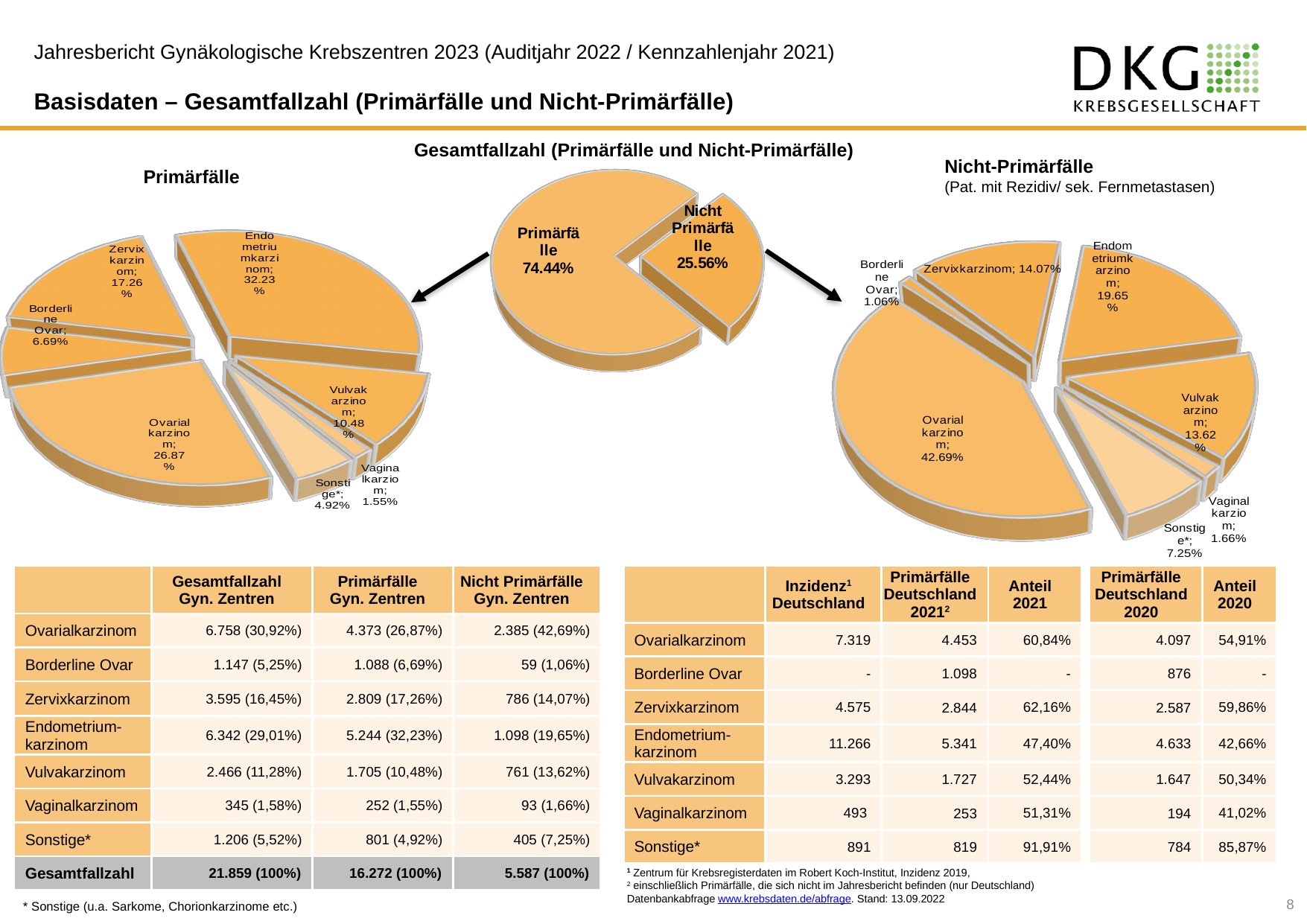
In the Gesamtfallzahl (Primärfälle und Nicht-Primärfälle) pie chart in the centre, what share is shown for Nicht Primärfälle? 25.56% In the Gesamtfallzahl (Primärfälle und Nicht-Primärfälle) pie chart in the centre, what share is shown for Primärfälle? 74.44% In the Nicht-Primärfälle pie chart, which category has the smallest slice? Borderline Ovar In the Nicht-Primärfälle pie chart, what is the difference between the shares for Endometriumkarzinom and Zervixkarzinom? 5.58% In the Primärfälle pie chart, which category has the smallest slice? Vaginalkarzinom In the Primärfälle pie chart, how many slices are there? 7 In the Primärfälle pie chart, what share is shown for Endometriumkarzinom? 32.23% In the Nicht-Primärfälle pie chart, what share is shown for Ovarialkarzinom? 42.69% What kind of chart is the Gesamtfallzahl (Primärfälle und Nicht-Primärfälle) chart in the centre of the slide? Pie chart In the Nicht-Primärfälle pie chart, which is larger: Zervixkarzinom or Vulvakarzinom? Zervixkarzinom In the Primärfälle pie chart, what share is shown for Ovarialkarzinom? 26.87% In the Primärfälle pie chart, which category has the largest slice? Endometriumkarzinom